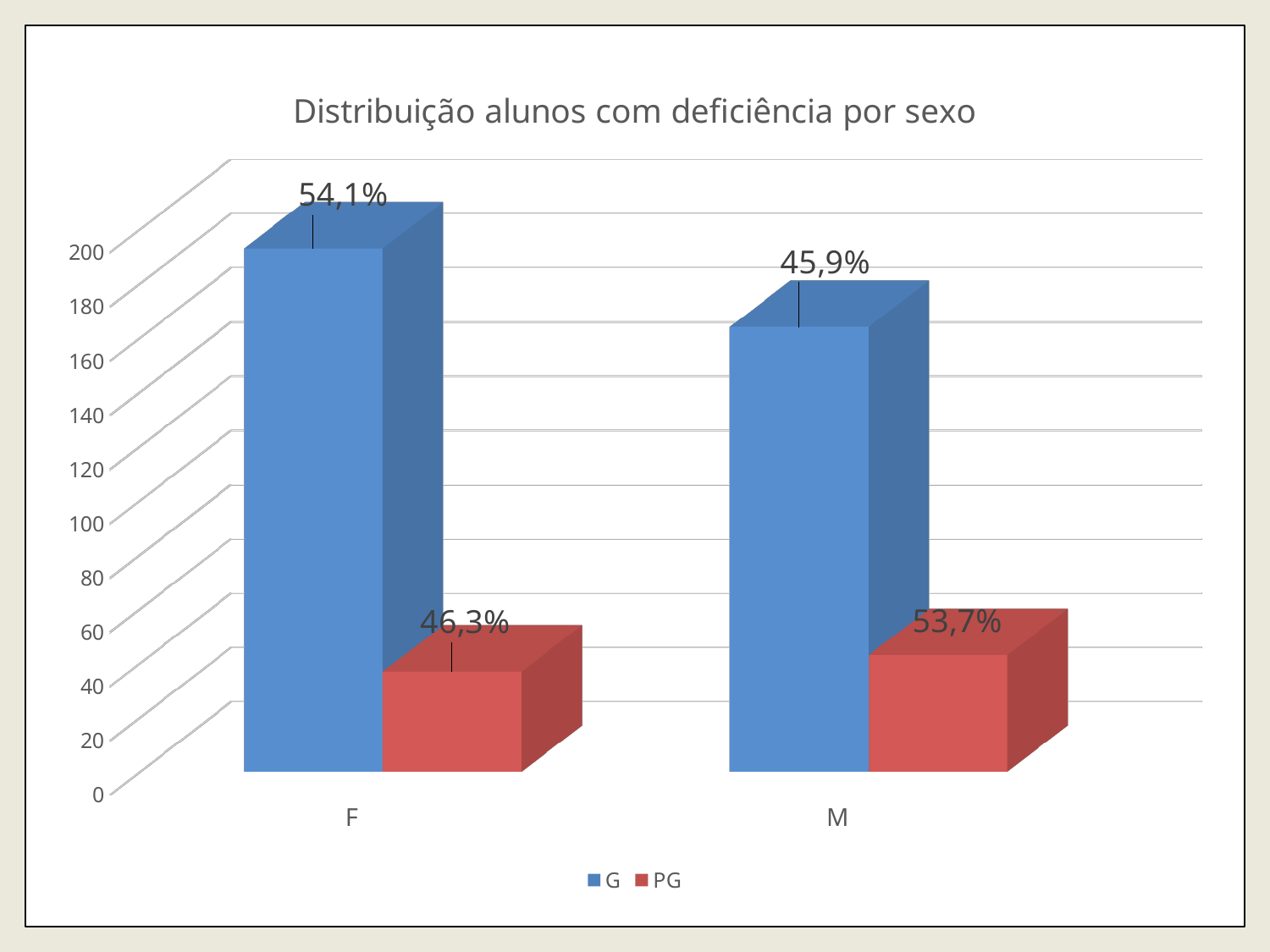
What is the data label shown on the G bar for F? 54,1% Which category has the tallest G bar? F How many categories are shown on the x axis? 2 Which category has the shortest bar in the chart? F How many series does the legend list? 2 What is the data label shown on the PG bar for F? 46,3% What is the data label shown on the PG bar for M? 53,7% Is the value for the PG bar for F greater or less than 100? less Is the value for the G bar for M greater or less than 140? greater What is the difference between the G label for F (54,1%) and the PG label for F (46,3%)? 7,8% Is the G bar taller for F or for M? F What is the data label shown on the G bar for M? 45,9%